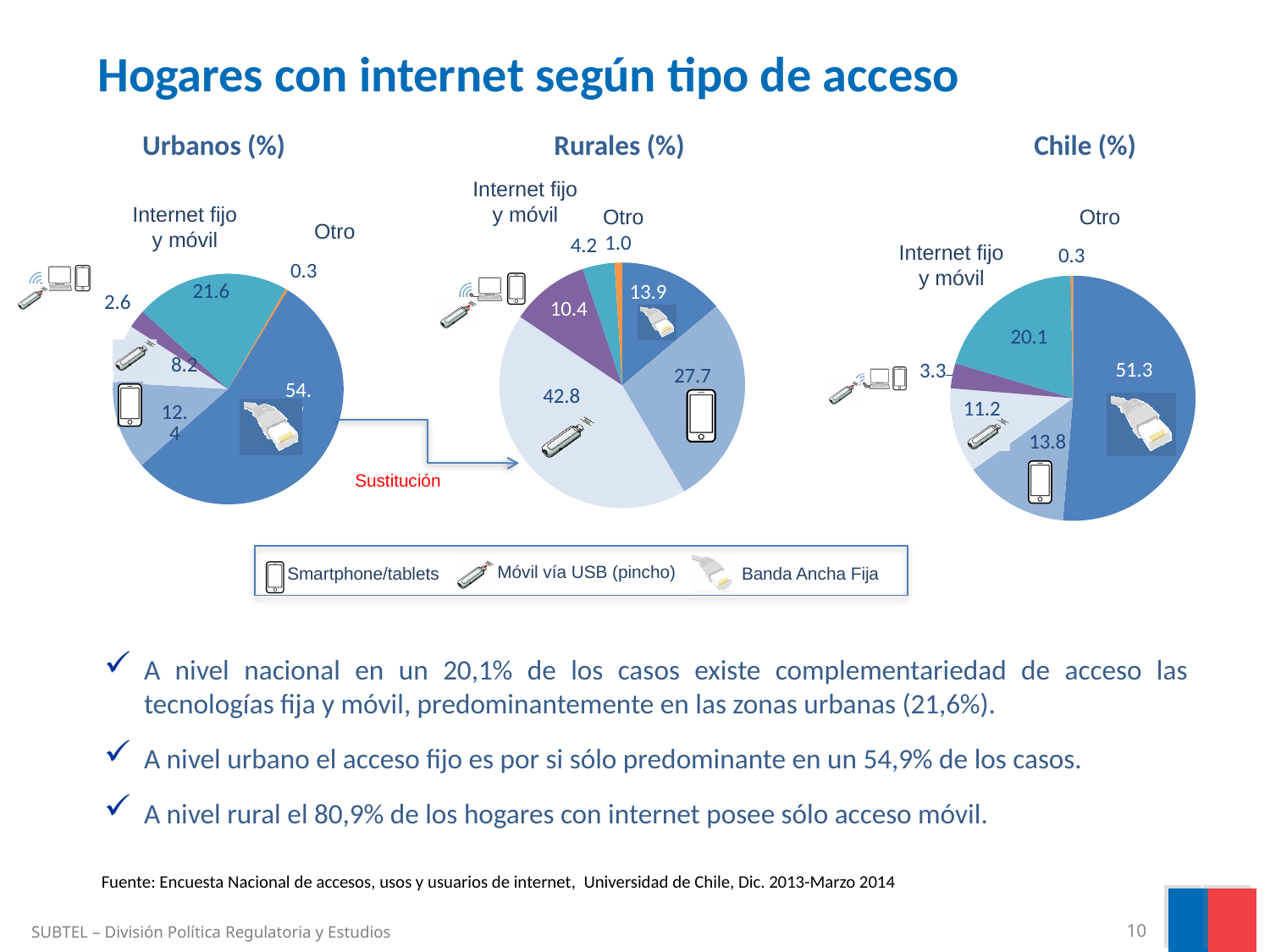
What is the difference between the "Internet fijo y móvil" value in the Urbanos (%) chart and the one in the Chile (%) chart? 1.5 In the Urbanos (%) pie chart, what value is shown for "Otro"? 0.3 In the Urbanos (%) pie chart, what value is shown for "Internet fijo y móvil"? 21.6 In the Chile (%) pie chart, what value is shown for the Banda Ancha Fija slice? 51.3 In the Chile (%) pie chart, what percentage is shown for "Internet fijo y móvil"? 20.1 In the Rurales (%) pie chart, what value is shown for "Otro"? 1.0 In the Rurales (%) pie chart, which is larger: the Smartphone/tablets slice or the Banda Ancha Fija slice? Smartphone/tablets What kind of chart is used to show the Chile (%) data? Pie chart How many pie charts are shown on the slide? 3 In the Rurales (%) pie chart, what value is shown for the Móvil vía USB (pincho) slice? 42.8 In the Rurales (%) pie chart, what value is shown for "Internet fijo y móvil"? 4.2 In the Rurales (%) pie chart, which category has the largest slice? Móvil vía USB (pincho)